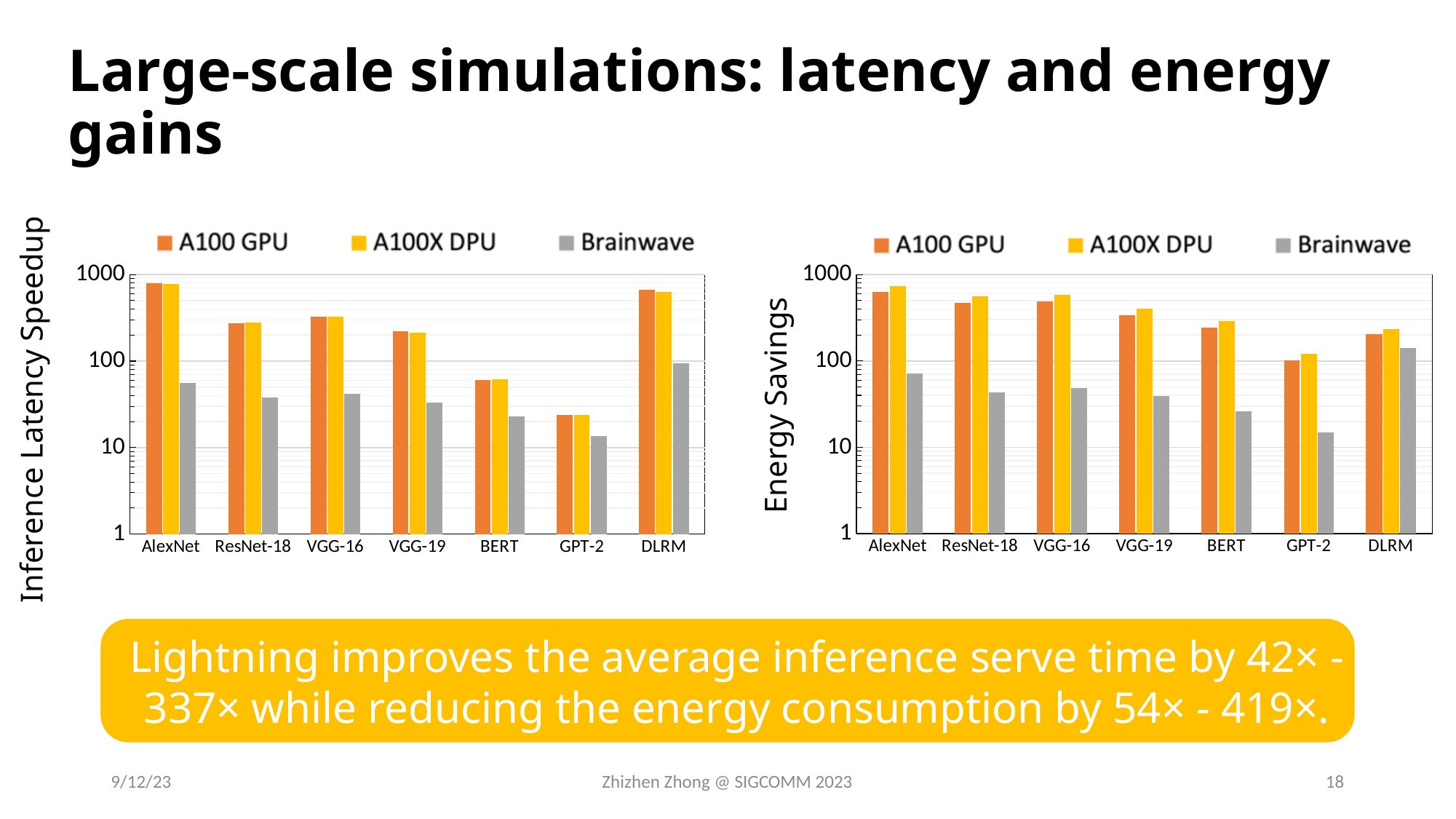
Which series is shown in grey in the legend of the Energy Savings chart? Brainwave In the Inference Latency Speedup chart, which is larger: the Brainwave value for DLRM or the Brainwave value for AlexNet? DLRM How many model categories are shown on the x axis of the Inference Latency Speedup chart? 7 What kind of chart is the Inference Latency Speedup chart on the left? bar chart In the Energy Savings chart, is the Brainwave value for BERT greater or less than 100? less How many series does the legend of the Energy Savings chart list? 3 In the Inference Latency Speedup chart, is the A100 GPU value for AlexNet greater or less than 100? greater In the Inference Latency Speedup chart, which model has the lowest A100 GPU speedup? GPT-2 In the Energy Savings chart, which model has the lowest Brainwave value? GPT-2 In the Inference Latency Speedup chart, is the A100 GPU value for GPT-2 greater or less than 100? less In the Energy Savings chart, which model has the highest A100X DPU value? AlexNet In the Inference Latency Speedup chart, which model has the highest A100 GPU speedup? AlexNet